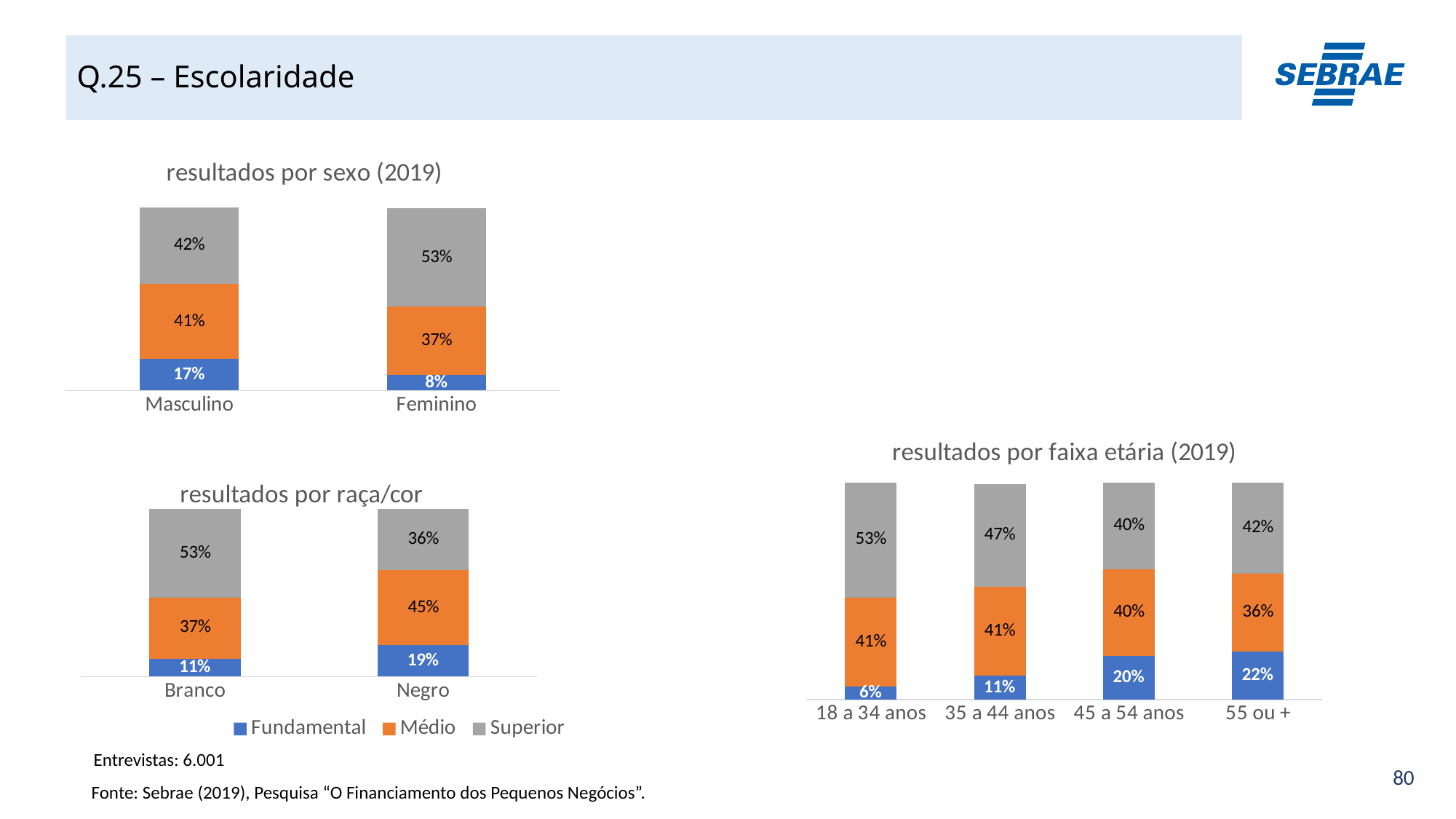
In the chart 'resultados por sexo (2019)', what is the Fundamental share for Masculino? 17% In the chart 'resultados por faixa etária (2019)', does the Fundamental share rise or fall as age increases along the x axis? rise In the chart 'resultados por faixa etária (2019)', what is the Fundamental share for 45 a 54 anos? 20% In the chart 'resultados por faixa etária (2019)', how many age groups are shown? 4 In the chart 'resultados por raça/cor', what is the total of the stacked bar for Branco? 101% In the chart 'resultados por raça/cor', what is the Médio share for Negro? 45% In the chart 'resultados por raça/cor', which category has the higher Superior share, Branco or Negro? Branco In the chart 'resultados por sexo (2019)', what is the Superior share for Feminino? 53% How many series does the legend list for the charts on the slide? 3 In the chart 'resultados por faixa etária (2019)', which age group has the highest Superior share? 18 a 34 anos In the chart 'resultados por sexo (2019)', what is the difference between the Médio shares of Masculino and Feminino? 4 percentage points In the chart 'resultados por faixa etária (2019)', which age group has the lowest Fundamental share? 18 a 34 anos